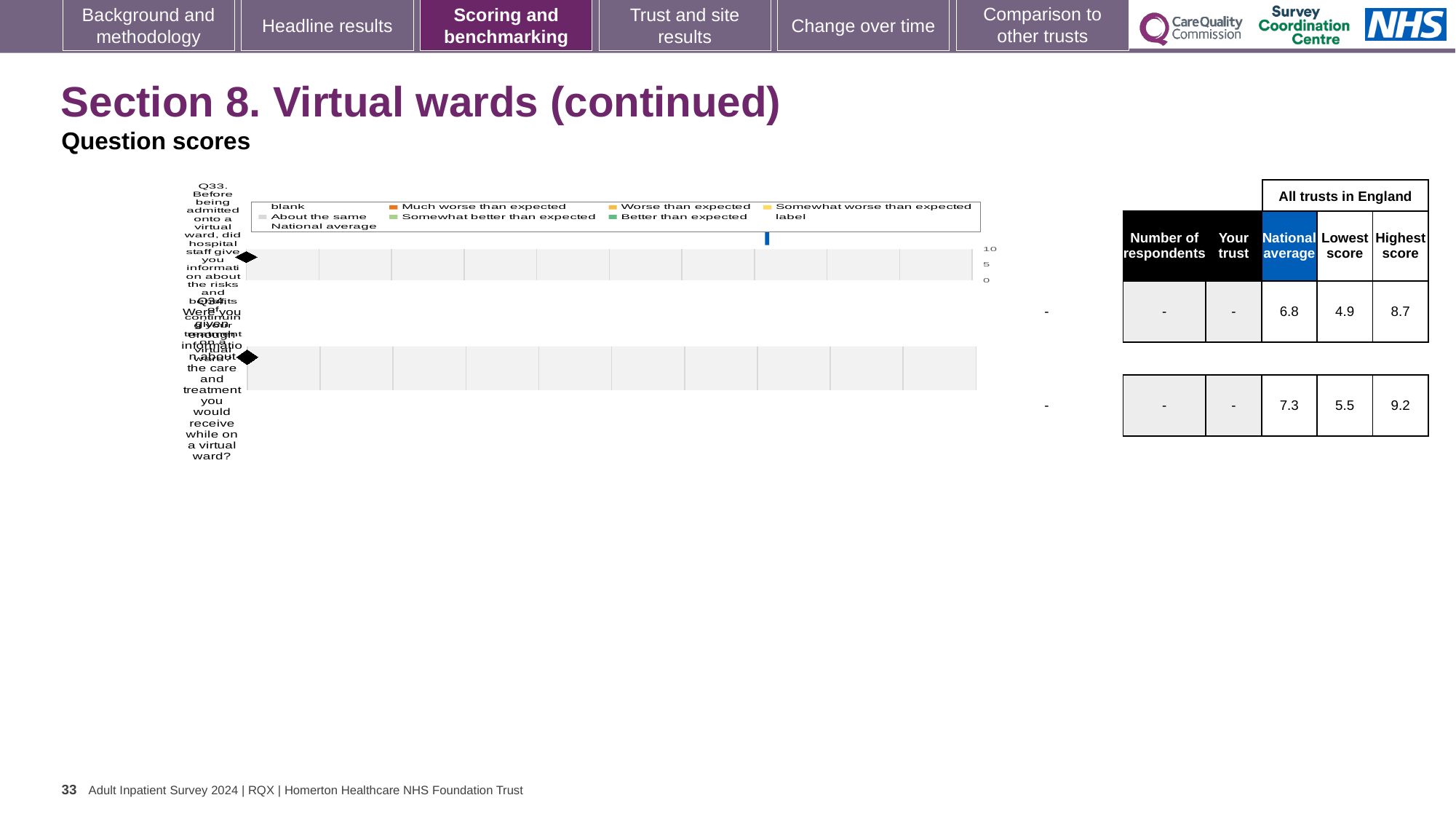
How many questions (categories) are listed on the chart's vertical axis? 2 In the table next to the chart, what is the national average score for Q34? 7.3 In the table next to the chart, what is the difference between the highest score and the lowest score for Q33? 3.8 In the table next to the chart, which question has the higher national average, Q33 or Q34? Q34 In the table next to the chart, what is the national average score for Q33? 6.8 Which legend entry is shown in orange on the chart? Much worse than expected In the table next to the chart, what is the highest score across all trusts in England for Q34? 9.2 In the table next to the chart, what is the difference between the highest score and the lowest score for Q34? 3.7 What kind of chart is shown on the slide? bar chart In the table next to the chart, what is the lowest score across all trusts in England for Q33? 4.9 In the table next to the chart, what is shown in the 'Your trust' column for Q33? -